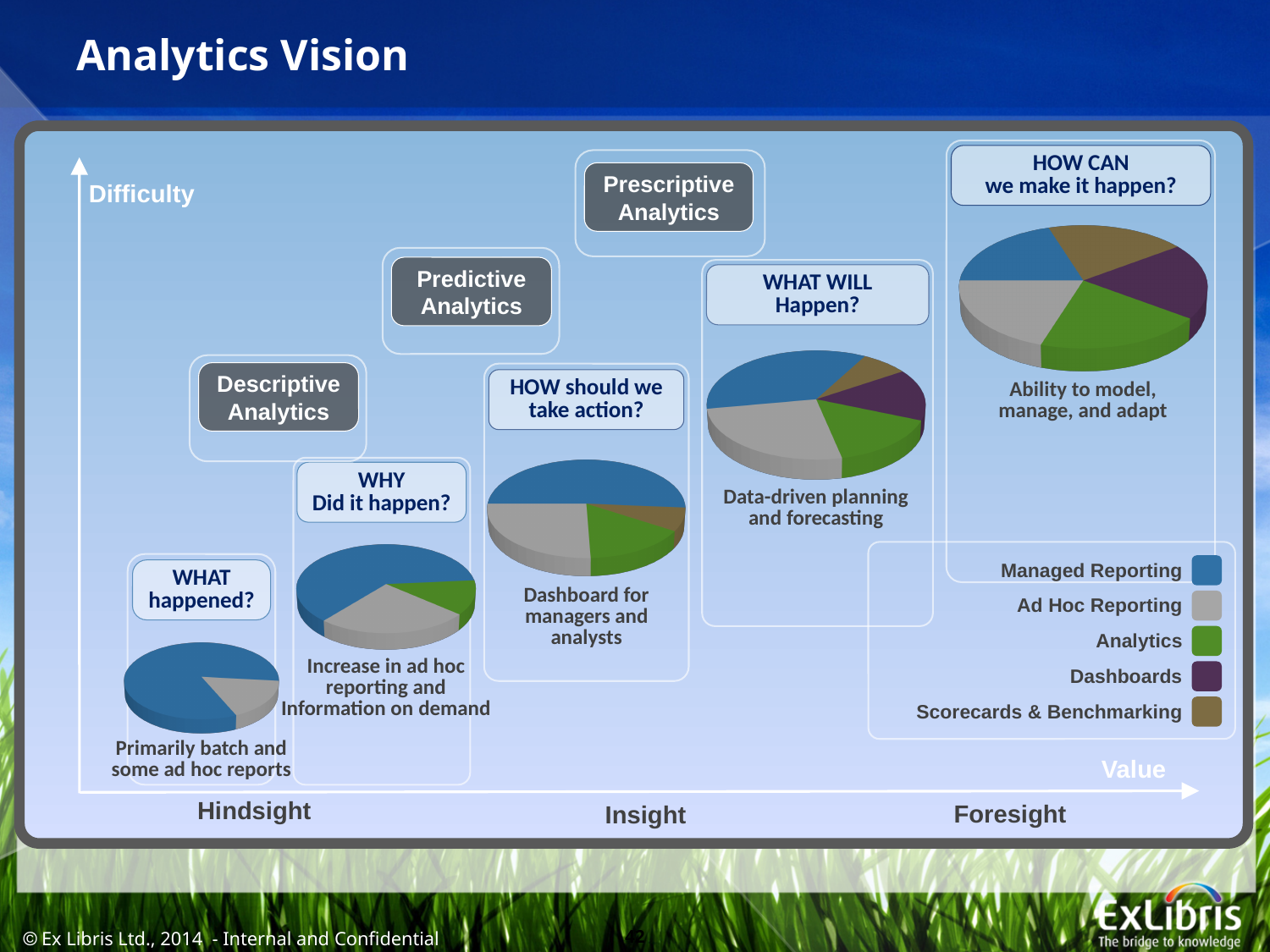
In the 'HOW CAN we make it happen?' pie chart, how many slices are there? 5 How many series does the legend list? 5 In the 'HOW should we take action?' pie chart, how many slices are there? 4 In the 'WHY Did it happen?' pie chart, which series has the smallest slice? Analytics In the 'WHAT happened?' pie chart, how many slices are there? 2 In the 'WHAT happened?' pie chart, which series has the largest slice? Managed Reporting What kind of charts are shown on the slide? Pie charts In the 'HOW should we take action?' pie chart, which series has the largest slice? Managed Reporting Which colour represents Dashboards in the legend? Purple In the 'WHAT WILL Happen?' pie chart, which series has the smallest slice? Scorecards & Benchmarking